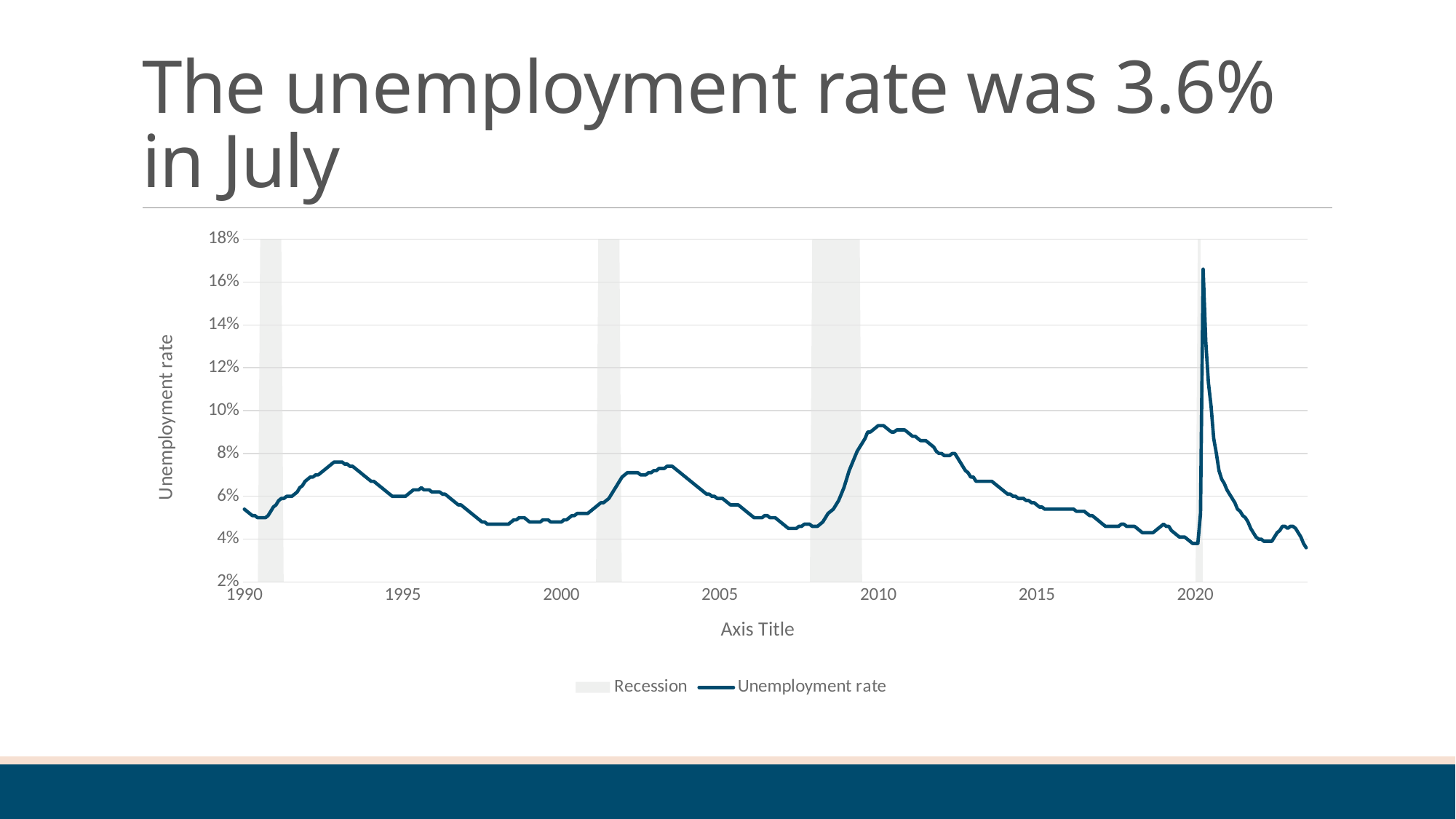
Is the peak unemployment rate around 2003 greater or less than 8%? less Between 2010 and 2019, does the unemployment rate generally rise or fall? fall What are the two entries in the chart legend? Recession and Unemployment rate Is the unemployment rate at the start of 1990 greater or less than 4%? greater Is the peak unemployment rate around 2020 greater or less than 16%? greater What is the label on the vertical axis of the chart? Unemployment rate How many entries does the chart legend list? 2 What kind of chart is shown on the slide? line chart Around which year does the unemployment rate reach its highest point on the chart? 2020 Which is higher: the peak unemployment rate around 2010 or the peak around 1993? the peak around 2010